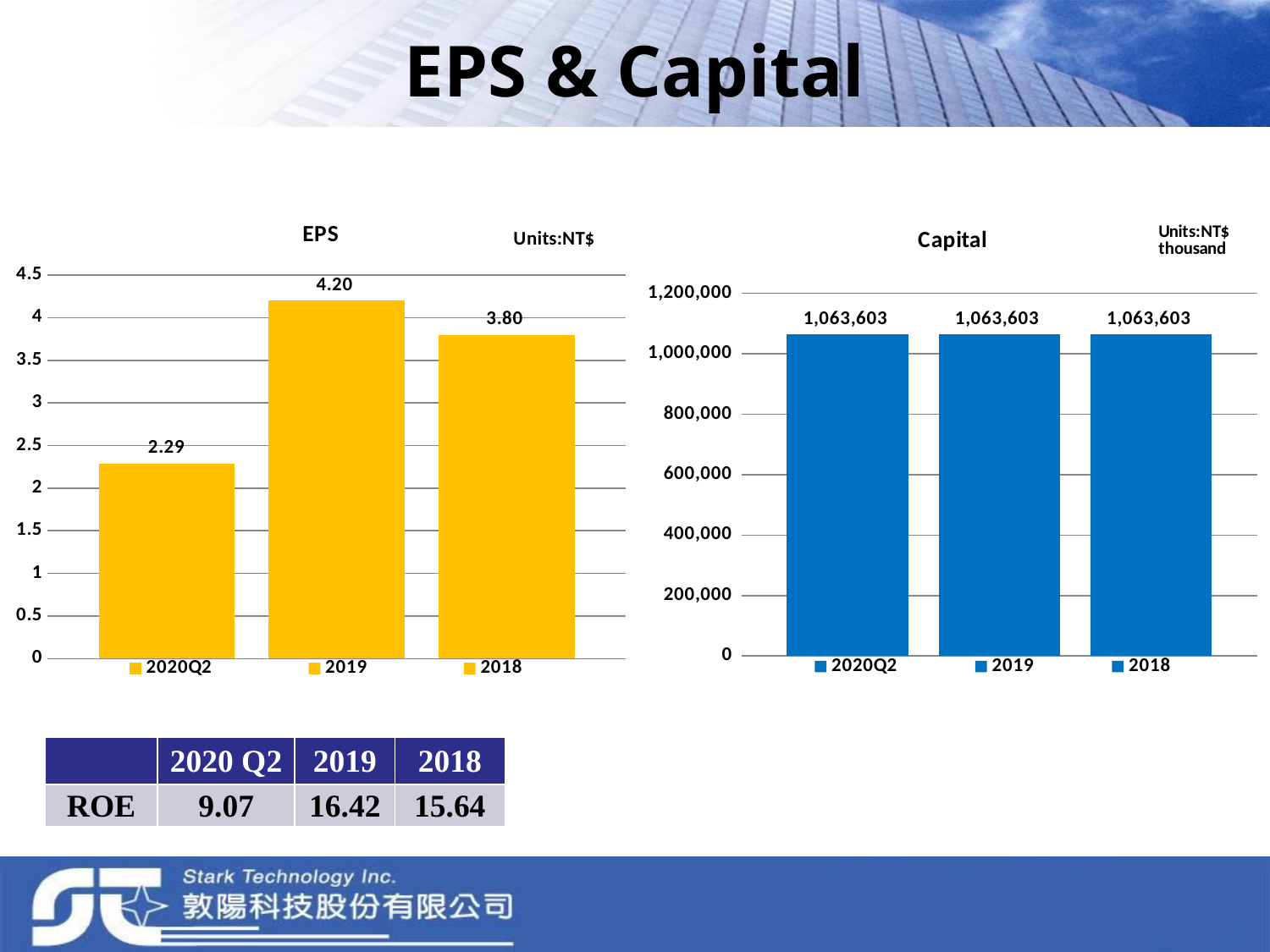
In the Capital chart, how many entries does the legend list? 3 In the Capital chart, what is the capital value for 2018? 1,063,603 What units are stated for the Capital chart? NT$ thousand In the EPS chart, what is the EPS value for 2019? 4.20 In the EPS chart, what is the difference between the EPS for 2019 and 2018? 0.40 What kind of chart is the Capital chart? Bar chart In the Capital chart, how many bars are plotted? 3 In the EPS chart, what is the EPS value for 2020Q2? 2.29 In the EPS chart, is the value for 2018 greater or less than 3.5? greater In the EPS chart, which is larger, the EPS for 2018 or for 2020Q2? 2018 In the EPS chart, which period has the highest EPS? 2019 In the EPS chart, which period has the lowest EPS? 2020Q2